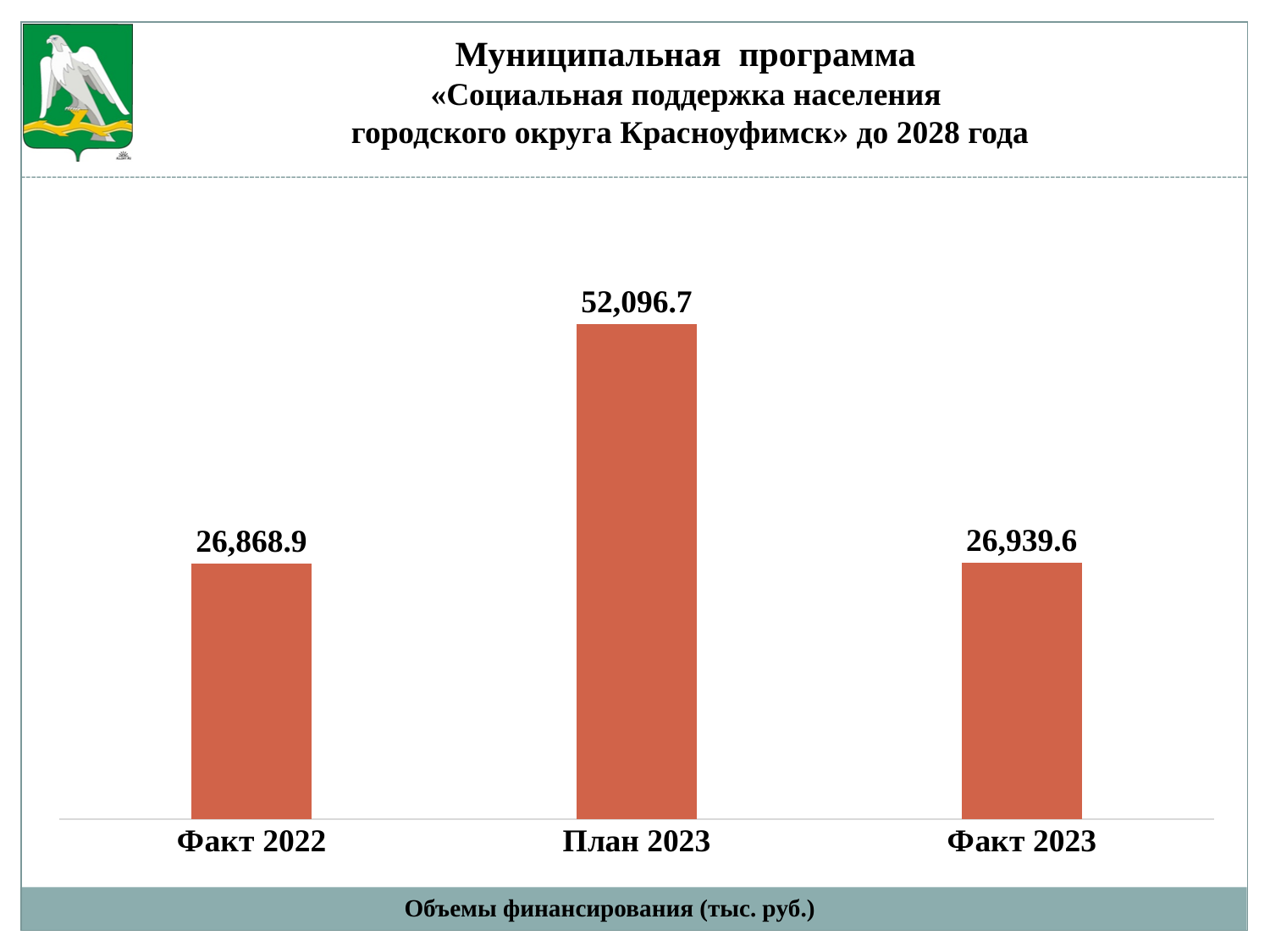
What is the value for Факт 2022? 26,868.9 How many categories are shown in the chart? 3 What unit of measurement is stated in the caption below the chart? тыс. руб. What is the difference between the values for План 2023 and Факт 2023? 25,157.1 What kind of chart is shown on the slide? Bar chart Which category has the lowest value? Факт 2022 What is the difference between the values for План 2023 and Факт 2022? 25,227.8 Which category has the highest value? План 2023 What is the value for План 2023? 52,096.7 What is the difference between the values for Факт 2023 and Факт 2022? 70.7 Which is larger, the value for План 2023 or the value for Факт 2023? План 2023 What is the value for Факт 2023? 26,939.6